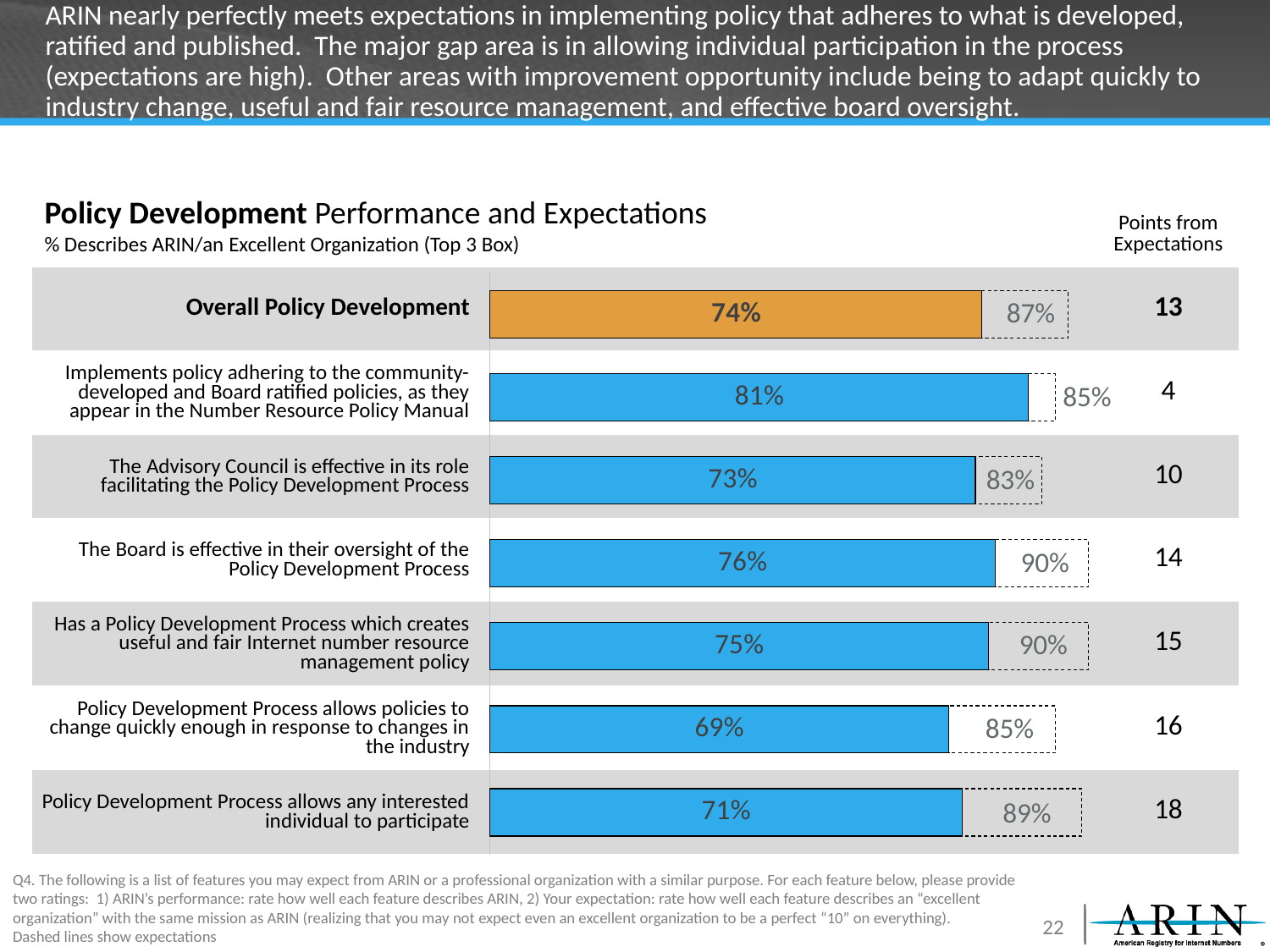
How many categories are shown in the chart? 7 Which category has the lowest performance value? Policy Development Process allows policies to change quickly enough in response to changes in the industry What is the difference between the expectation and performance values for "Policy Development Process allows any interested individual to participate"? 18 What is the performance value for Overall Policy Development? 74% What is the performance value for "Policy Development Process allows any interested individual to participate"? 71% Which category has the highest performance value? Implements policy adhering to the community-developed and Board ratified policies, as they appear in the Number Resource Policy Manual What is the "Points from Expectations" value for "Has a Policy Development Process which creates useful and fair Internet number resource management policy"? 15 What is the expectation value for "The Board is effective in their oversight of the Policy Development Process"? 90% Which category has the largest gap in "Points from Expectations"? Policy Development Process allows any interested individual to participate Which is larger: the performance value for "The Advisory Council is effective in its role facilitating the Policy Development Process" or for "The Board is effective in their oversight of the Policy Development Process"? The Board is effective in their oversight of the Policy Development Process According to the footnote, what do the dashed lines in the chart show? Expectations What kind of chart is shown on the slide? Bar chart